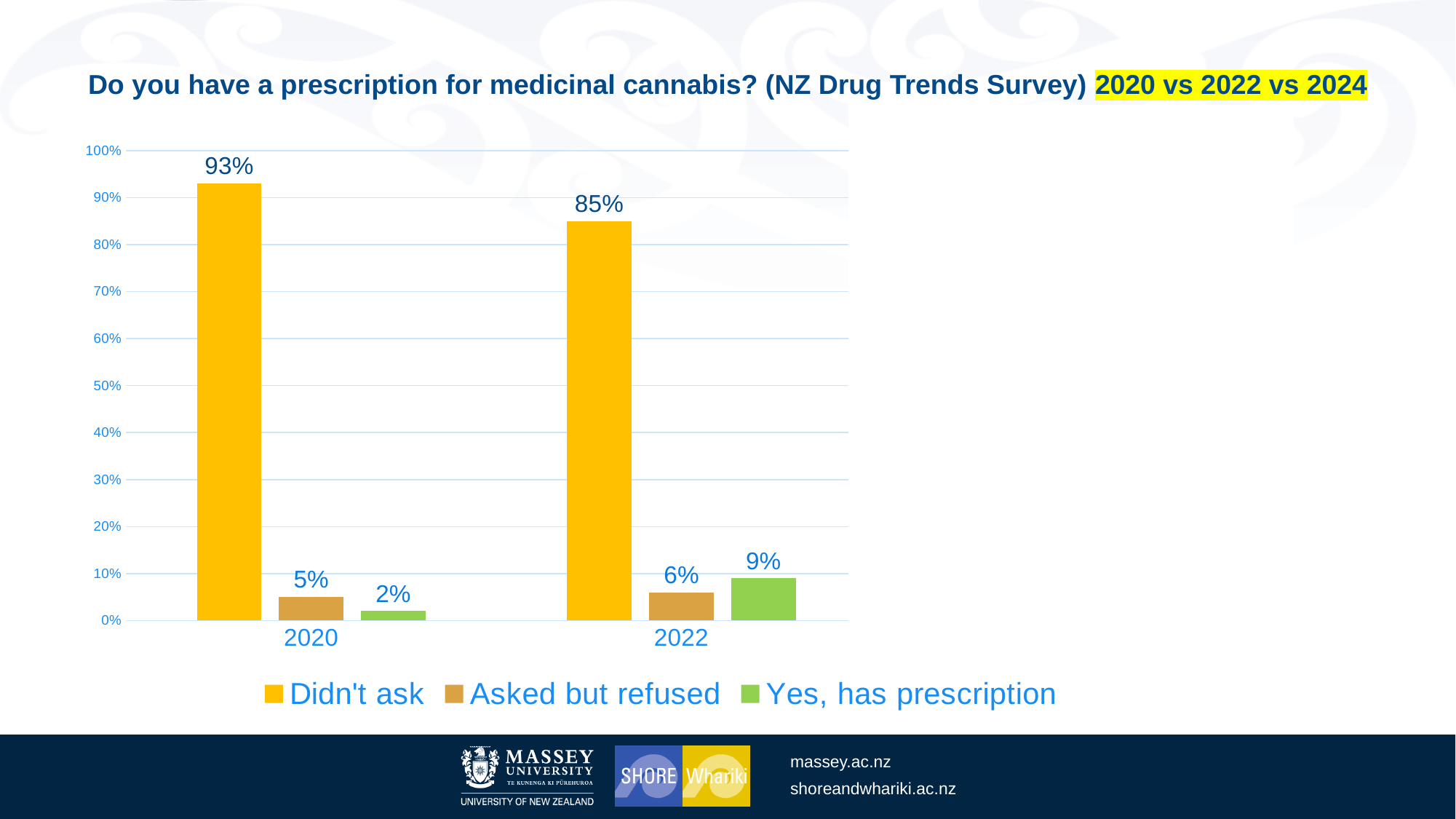
What kind of chart is shown on the slide? Bar chart What is the value for 'Asked but refused' in 2022? 6% Which is larger: 'Asked but refused' in 2020 or 'Yes, has prescription' in 2022? Yes, has prescription in 2022 How many series does the legend list? 3 How many years are shown on the x axis of the chart? 2 What is the value for 'Yes, has prescription' in 2020? 2% Which response category has the lowest value in 2020? Yes, has prescription What percentage of respondents in 2022 said 'Yes, has prescription'? 9% What percentage of respondents in 2020 said they didn't ask for a prescription? 93% By how many percentage points did 'Didn't ask' fall from 2020 to 2022? 8 percentage points Did the 'Yes, has prescription' value rise or fall from 2020 to 2022? Rise Which response category has the highest value in 2022? Didn't ask